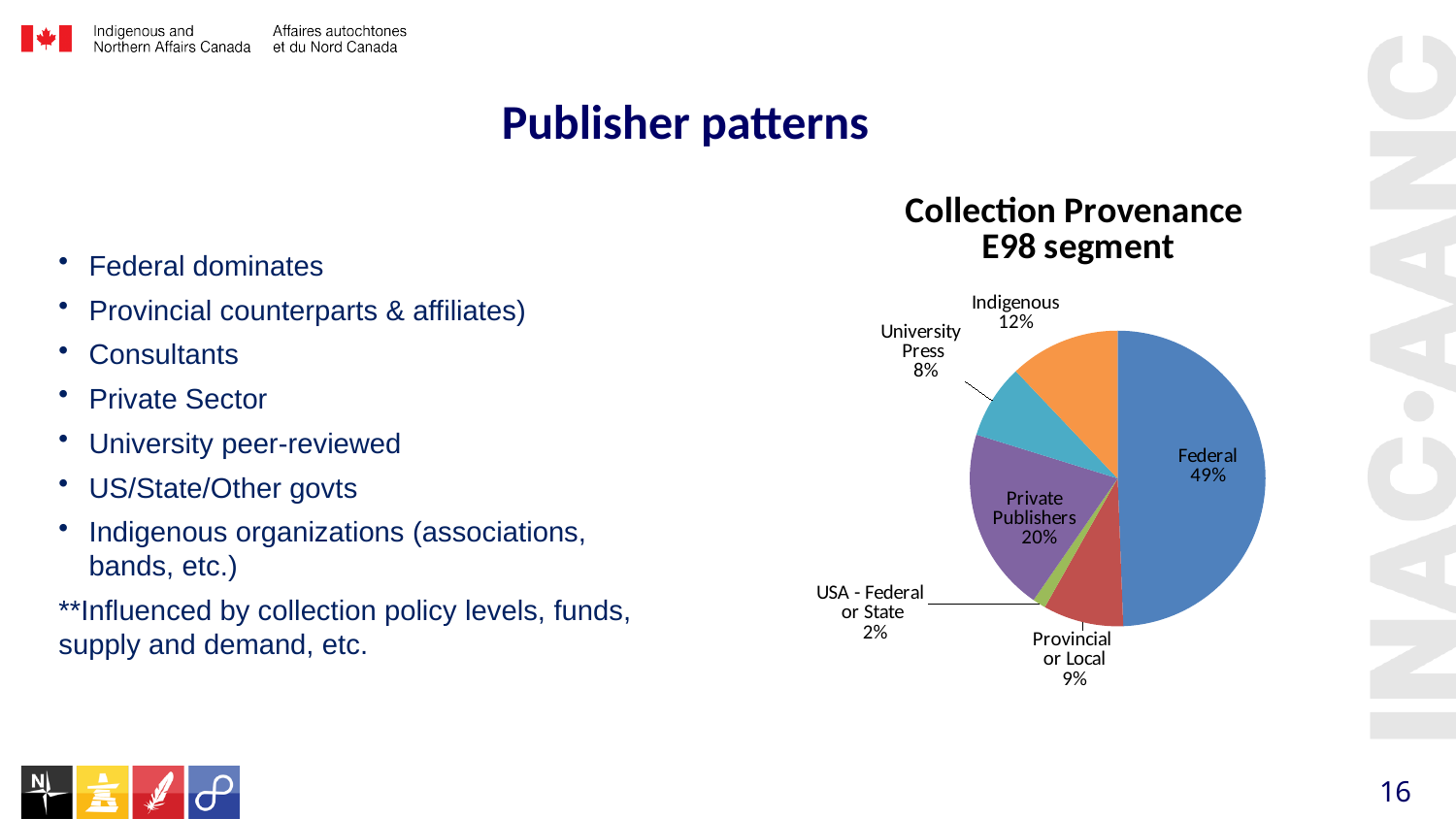
What percentage is shown for Provincial or Local? 9% How many slices does the pie chart have? 6 Which category has the largest slice of the pie? Federal Which is larger, the share for Indigenous or the share for Provincial or Local? Indigenous What is the title of the chart? Collection Provenance E98 segment Which category has the smallest slice of the pie? USA - Federal or State What percentage is shown for University Press? 8% What percentage is shown for Indigenous? 12% What type of chart is shown on the slide? pie chart What percentage is shown for Private Publishers? 20% What is the difference in percentage points between Federal and Private Publishers? 29 What share of the pie does Federal hold? 49%